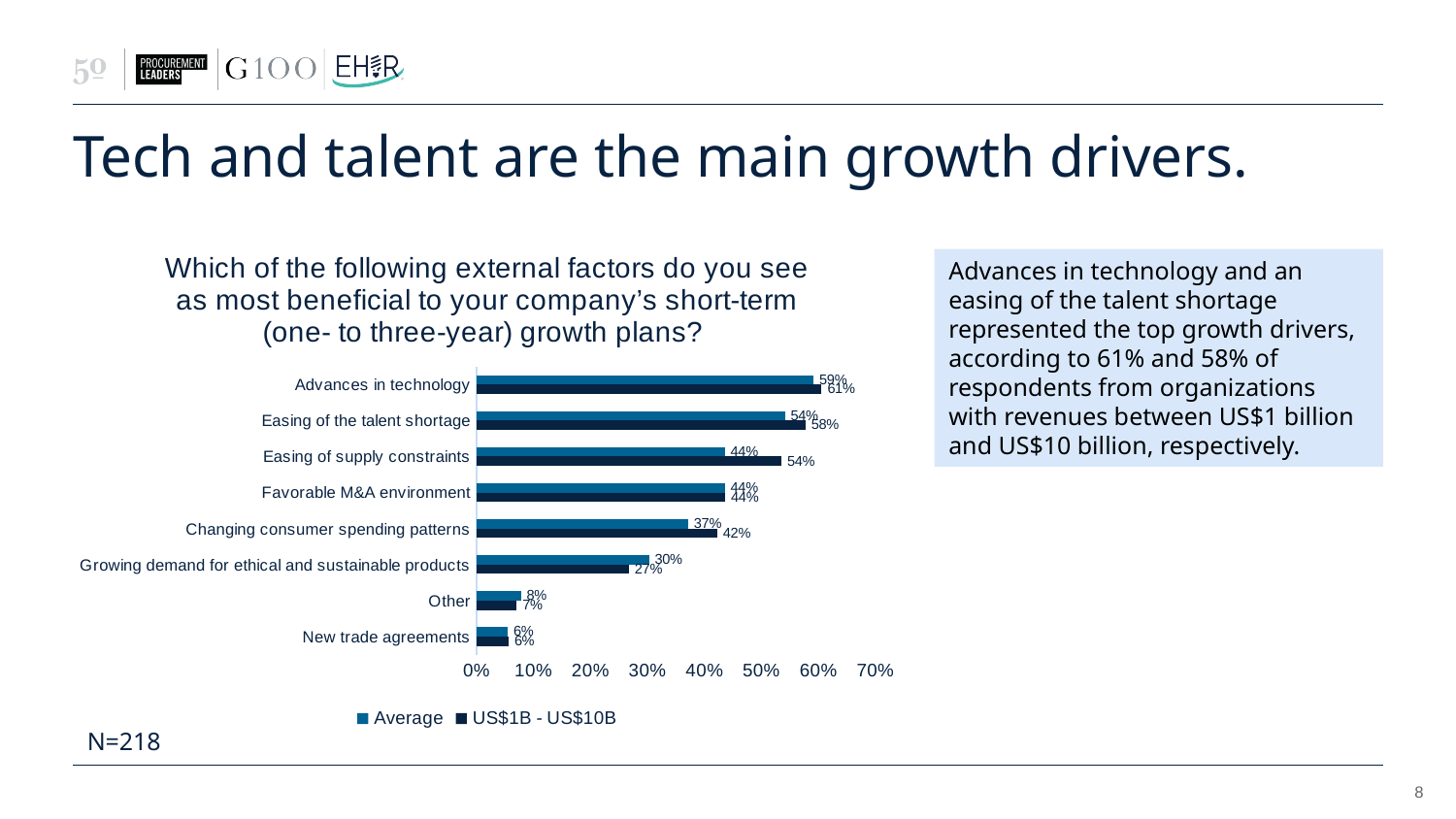
How many series does the legend list? 2 How many categories are shown on the chart? 8 What is the Average value for Growing demand for ethical and sustainable products? 30% For Changing consumer spending patterns, which is larger: the Average value or the US$1B - US$10B value? US$1B - US$10B What kind of chart is shown on the slide? Bar chart What is the US$1B - US$10B value for Easing of supply constraints? 54% Which category has the lowest US$1B - US$10B value? New trade agreements What is the difference between the US$1B - US$10B value and the Average value for Easing of supply constraints? 10% Which category has the highest Average value? Advances in technology What is the US$1B - US$10B value for Easing of the talent shortage? 58% Is the Average value for Favorable M&A environment greater or less than 40%? greater What is the Average value for Advances in technology? 59%